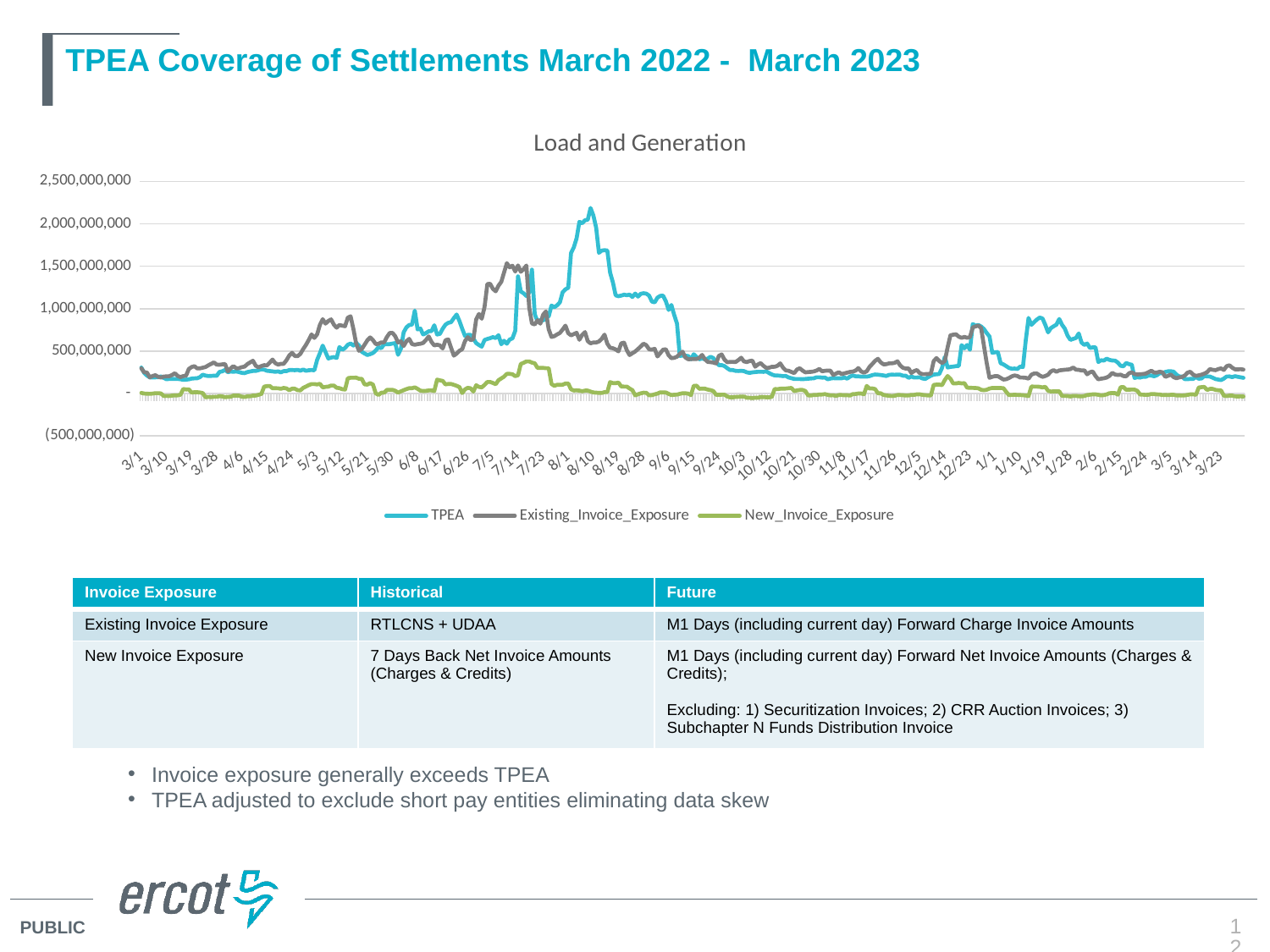
Is the peak value of TPEA around 8/10 greater or less than 2,000,000,000? greater What kind of chart is shown on the slide? Line chart Which colour is used for the TPEA series in the chart? Blue Does the TPEA series rise or fall between 8/10 and 10/3? Fall Is the highest value of New_Invoice_Exposure greater or less than 500,000,000? less Around 8/10, which is larger: TPEA or Existing_Invoice_Exposure? TPEA Around 7/5, which is larger: Existing_Invoice_Exposure or TPEA? Existing_Invoice_Exposure How many series does the chart legend list? 3 What is the title of the chart? Load and Generation Which series reaches the highest peak on the chart? TPEA Which series stays lowest across the whole chart? New_Invoice_Exposure Is the peak of Existing_Invoice_Exposure around 7/14 greater or less than 1,000,000,000? greater